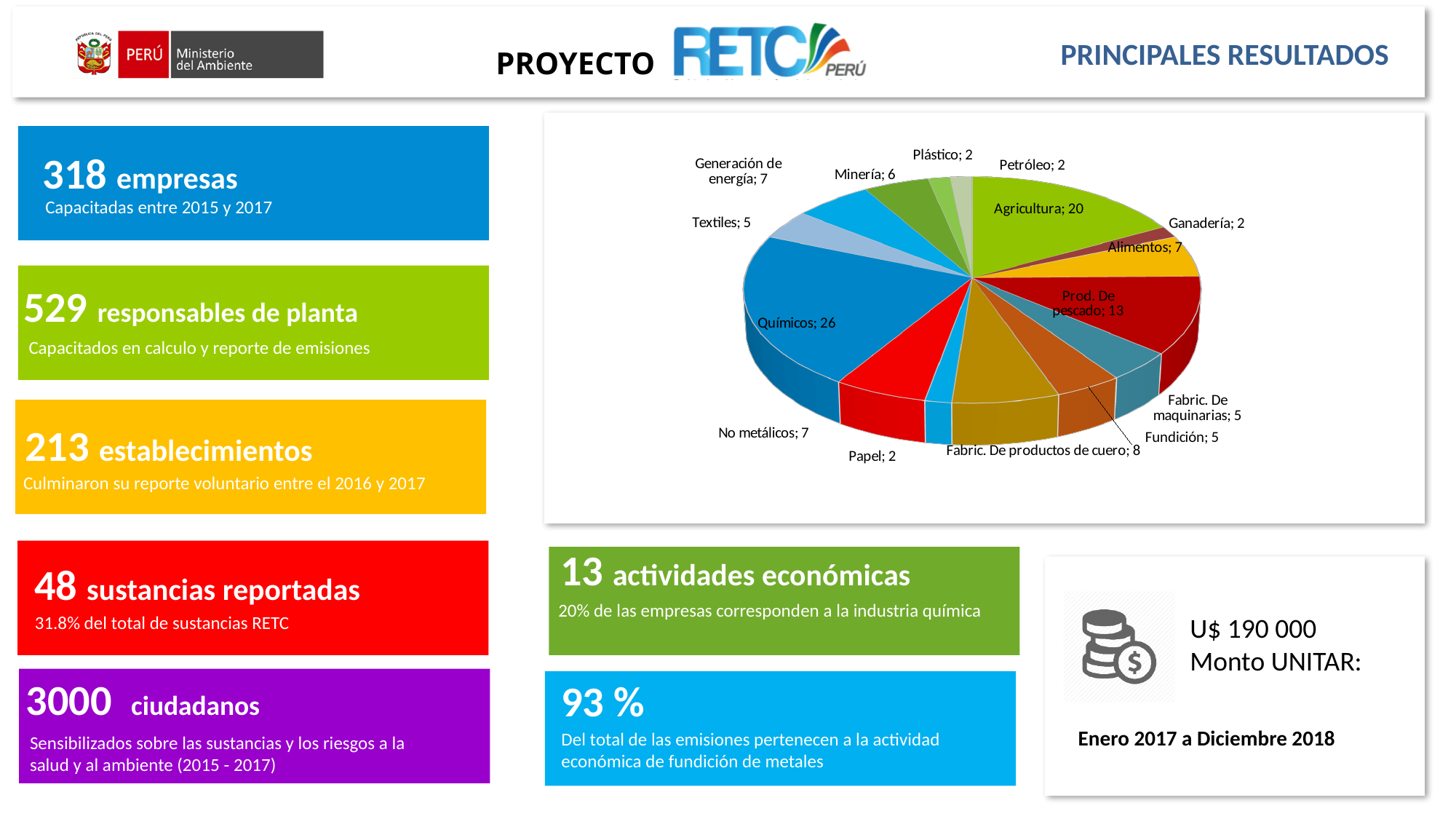
What is the difference between the values for Químicos and Agricultura? 6 What is the value for Químicos in the pie chart? 26 What is the value for Prod. De pescado in the pie chart? 13 What is the value for Agricultura in the pie chart? 20 What is the value for Textiles in the pie chart? 5 How many categories are shown in the pie chart? 15 Which is larger in the pie chart, Agricultura or Prod. De pescado? Agricultura What kind of chart is shown on the slide? Pie chart What is the value for Minería in the pie chart? 6 Which category has the largest slice in the pie chart? Químicos What is the value for Fabric. De productos de cuero in the pie chart? 8 What is the difference between the values for Prod. De pescado and Fabric. De productos de cuero? 5